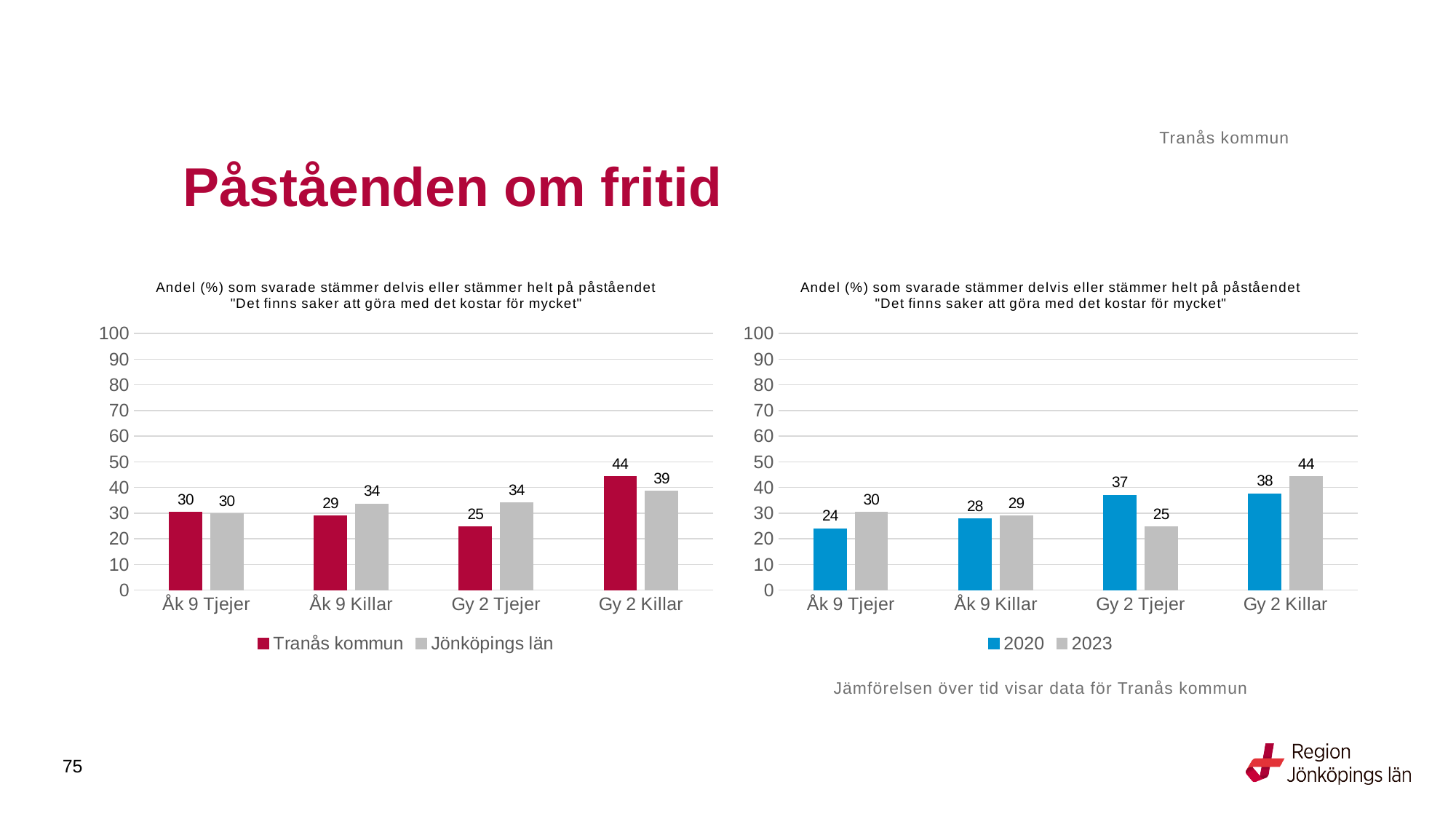
In the left chart, what is the value for Jönköpings län for Gy 2 Tjejer? 34 In the left chart, which is larger for Gy 2 Killar: Tranås kommun or Jönköpings län? Tranås kommun How many categories are shown on the x axis of the left chart? 4 In the left chart, what is the difference between Jönköpings län and Tranås kommun for Gy 2 Tjejer? 9 In the right chart, which category has the highest value for 2023? Gy 2 Killar In the right chart, how many series does the legend list? 2 In the left chart, what is the value for Tranås kommun for Gy 2 Killar? 44 In the left chart, which category has the lowest value for Tranås kommun? Gy 2 Tjejer In the right chart, what is the value for 2020 for Åk 9 Tjejer? 24 What kind of chart is the right chart? Bar chart In the right chart, what is the value for 2023 for Gy 2 Killar? 44 In the right chart, what is the difference between 2020 and 2023 for Gy 2 Tjejer? 12